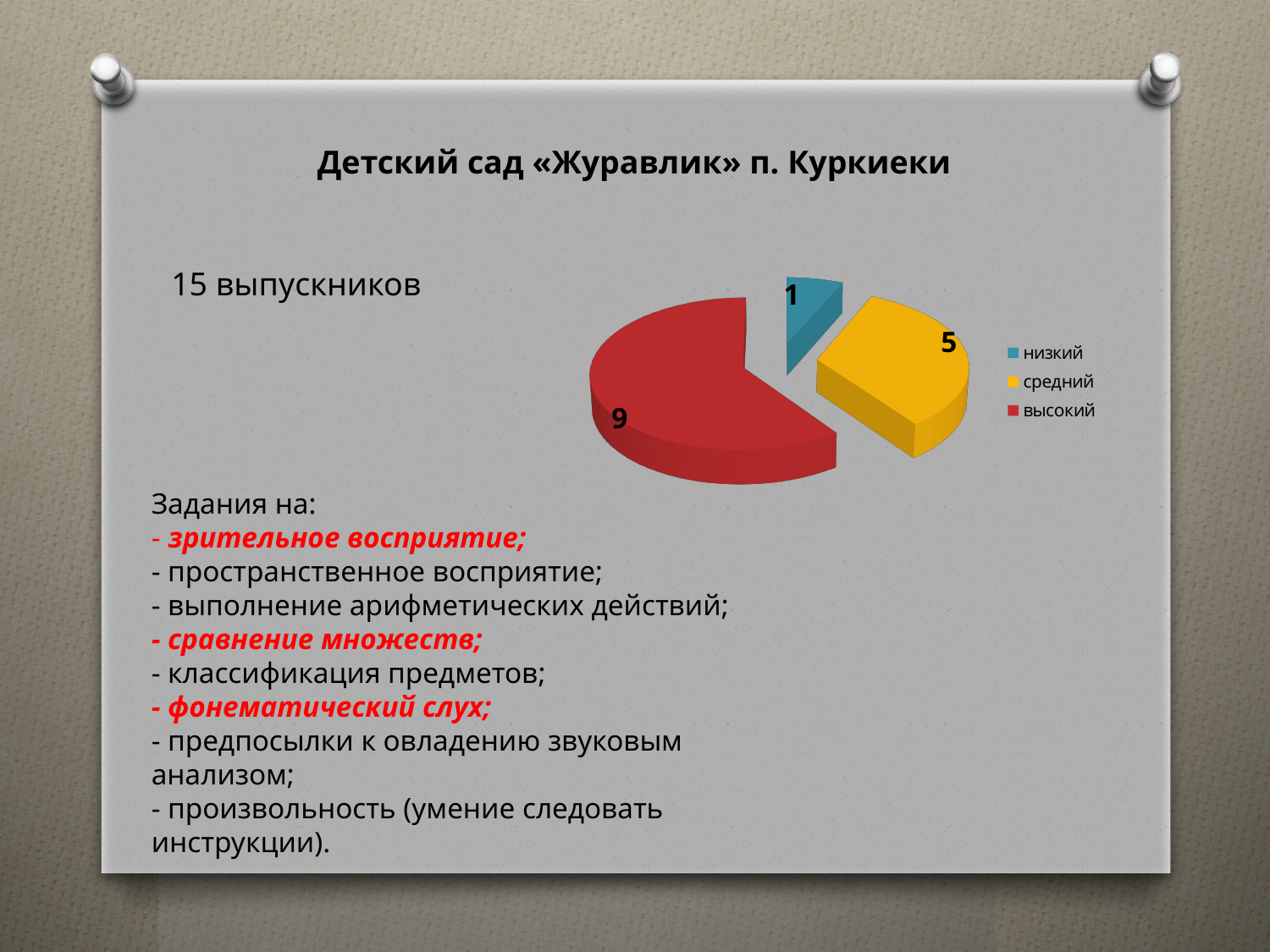
Which is larger, the value for "средний" or the value for "низкий"? средний How many entries does the legend list? 3 What is the value for the "средний" slice? 5 What is the value for the "высокий" slice? 9 Which category has the largest slice? высокий What is the total of all slices in the pie chart? 15 Which category has the smallest slice? низкий What type of chart is shown on the slide? pie chart What colour is the "высокий" slice? red How many slices does the pie chart have? 3 What is the value for the "низкий" slice? 1 What is the difference between the "высокий" and "средний" values? 4